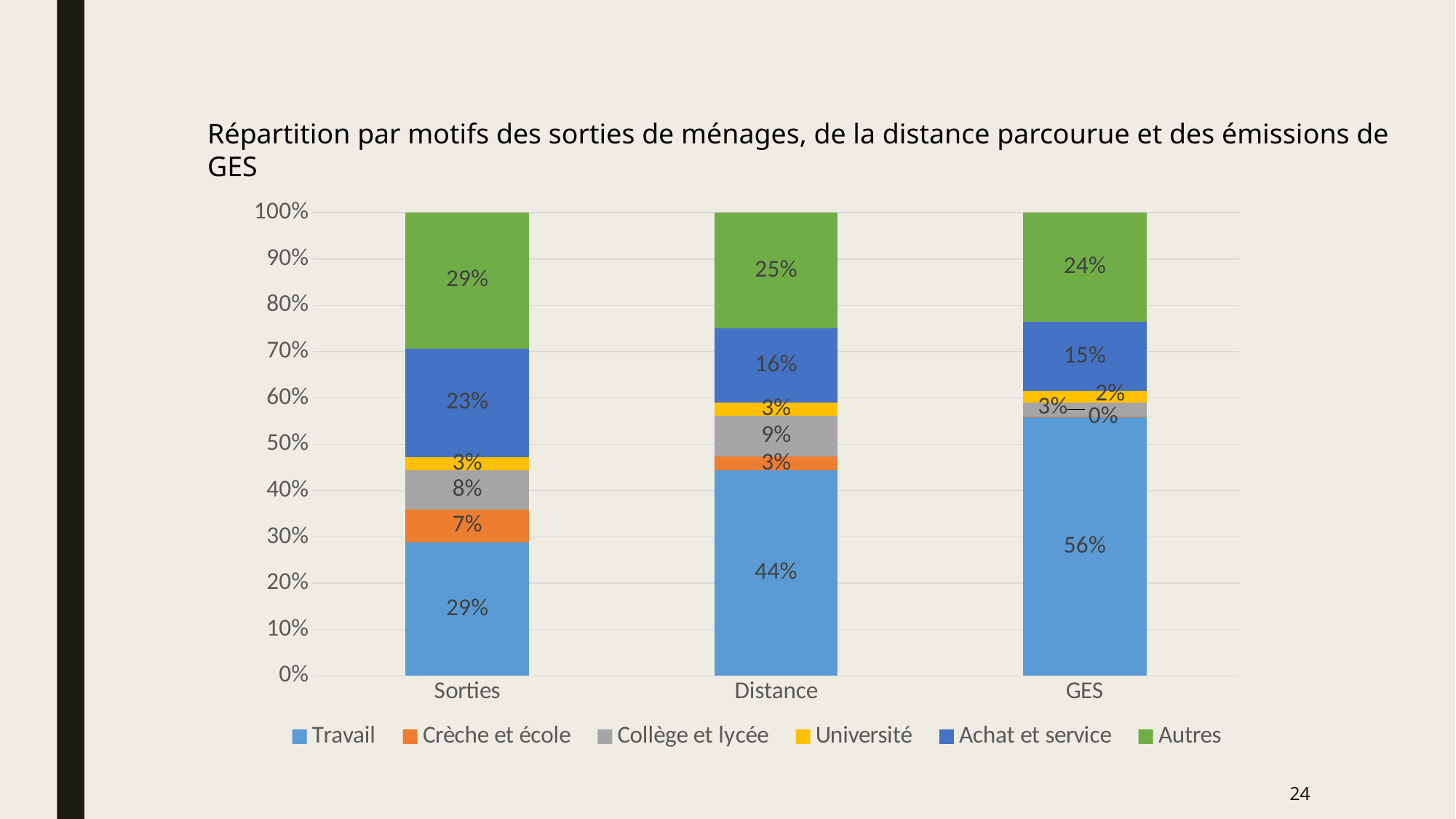
What is the value of Crèche et école for GES? 0% Is the Crèche et école value larger for Sorties or for Distance? Sorties What is the value of Achat et service for Sorties? 23% What is the value of Autres for Distance? 25% Which category has the highest value for Travail? GES What is the value of Collège et lycée for Distance? 9% What is the difference between the Travail value for GES and the Travail value for Sorties? 27% What kind of chart is shown on the slide? Stacked bar chart Which category has the lowest value for Achat et service? GES How many categories are shown on the x axis? 3 How many series does the legend list? 6 What is the value of Travail for GES? 56%